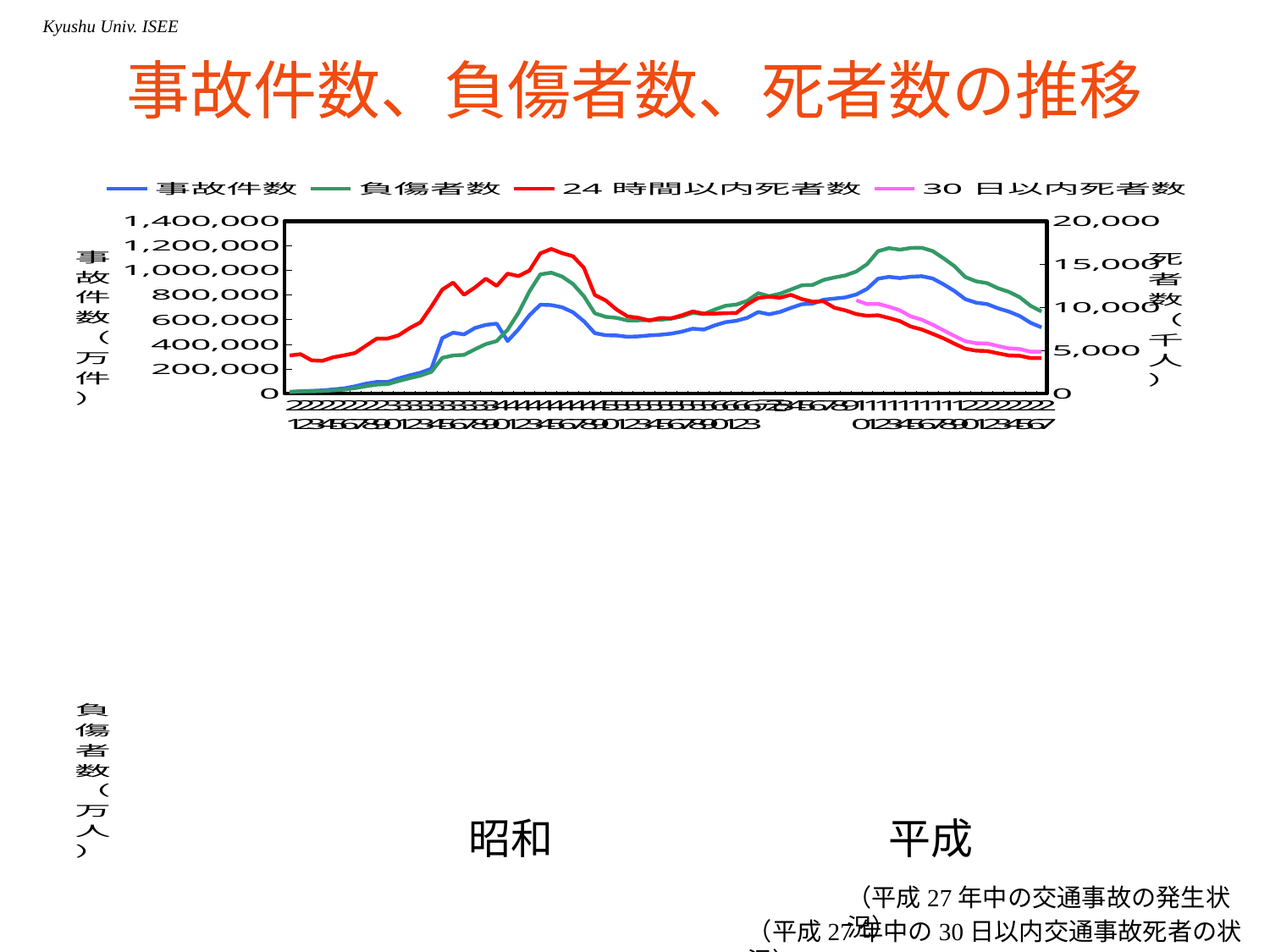
What is the highest tick value shown on the right vertical axis? 20,000 How many series does the legend list? 4 What is the title of the chart on the slide? 事故件数、負傷者数、死者数の推移 What kind of chart is shown on the slide? line chart Toward the right end of the chart, is the 負傷者数 series rising or falling? falling Is the peak value of the 負傷者数 series greater or less than 1,000,000? greater Which colour is used for the 事故件数 series? blue Is the peak value of the 24 時間以内死者数 series greater or less than 15,000? greater Toward the right end of the chart, is the 事故件数 series rising or falling? falling What is the highest tick value shown on the left vertical axis? 1,400,000 Which series reaches the highest peak on the chart, 事故件数 or 負傷者数? 負傷者数 Is the final value of the 24 時間以内死者数 series at the right end of the chart greater or less than 5,000? less